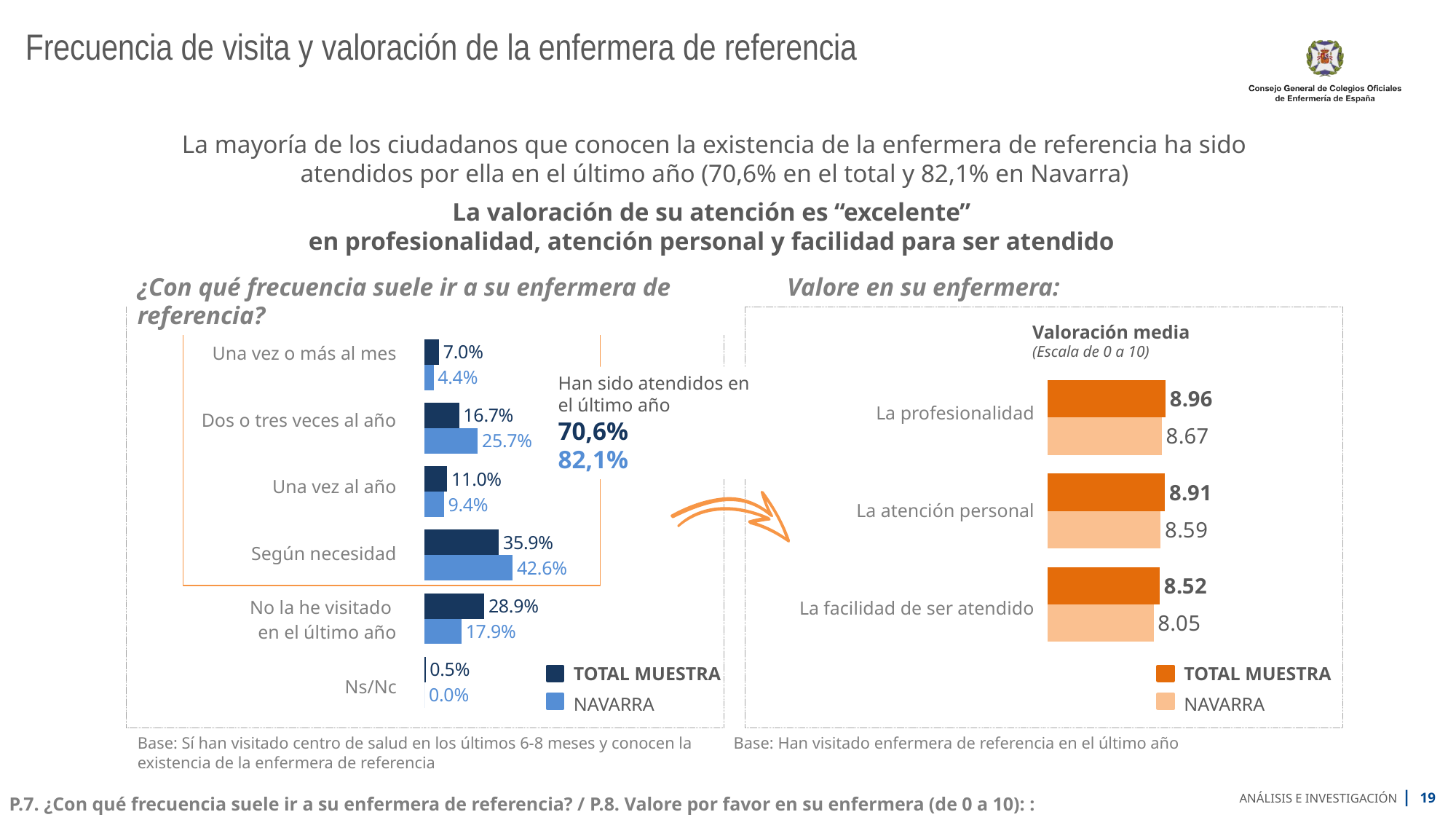
In the right chart (Valore en su enfermera), which item has the lowest TOTAL MUESTRA score? La facilidad de ser atendido In the left chart (¿Con qué frecuencia suele ir a su enfermera de referencia?), which category has the highest NAVARRA value? Según necesidad In the left chart (¿Con qué frecuencia suele ir a su enfermera de referencia?), what is the NAVARRA value for 'Dos o tres veces al año'? 25.7% What kind of chart is the right chart (Valore en su enfermera)? Bar chart In the right chart (Valore en su enfermera), what is the difference between the TOTAL MUESTRA and NAVARRA scores for 'La profesionalidad'? 0.29 How many categories are shown in the left chart (¿Con qué frecuencia suele ir a su enfermera de referencia?)? 6 In the left chart (¿Con qué frecuencia suele ir a su enfermera de referencia?), what is the TOTAL MUESTRA value for 'Según necesidad'? 35.9% How many series does the legend of the right chart (Valore en su enfermera) list? 2 In the left chart (¿Con qué frecuencia suele ir a su enfermera de referencia?), which is larger for 'Una vez al año': TOTAL MUESTRA or NAVARRA? TOTAL MUESTRA In the left chart (¿Con qué frecuencia suele ir a su enfermera de referencia?), what is the difference between the TOTAL MUESTRA and NAVARRA values for 'No la he visitado en el último año'? 11.0% In the right chart (Valore en su enfermera), what is the NAVARRA score for 'La atención personal'? 8.59 In the left chart (¿Con qué frecuencia suele ir a su enfermera de referencia?), which category has the lowest TOTAL MUESTRA value? Ns/Nc